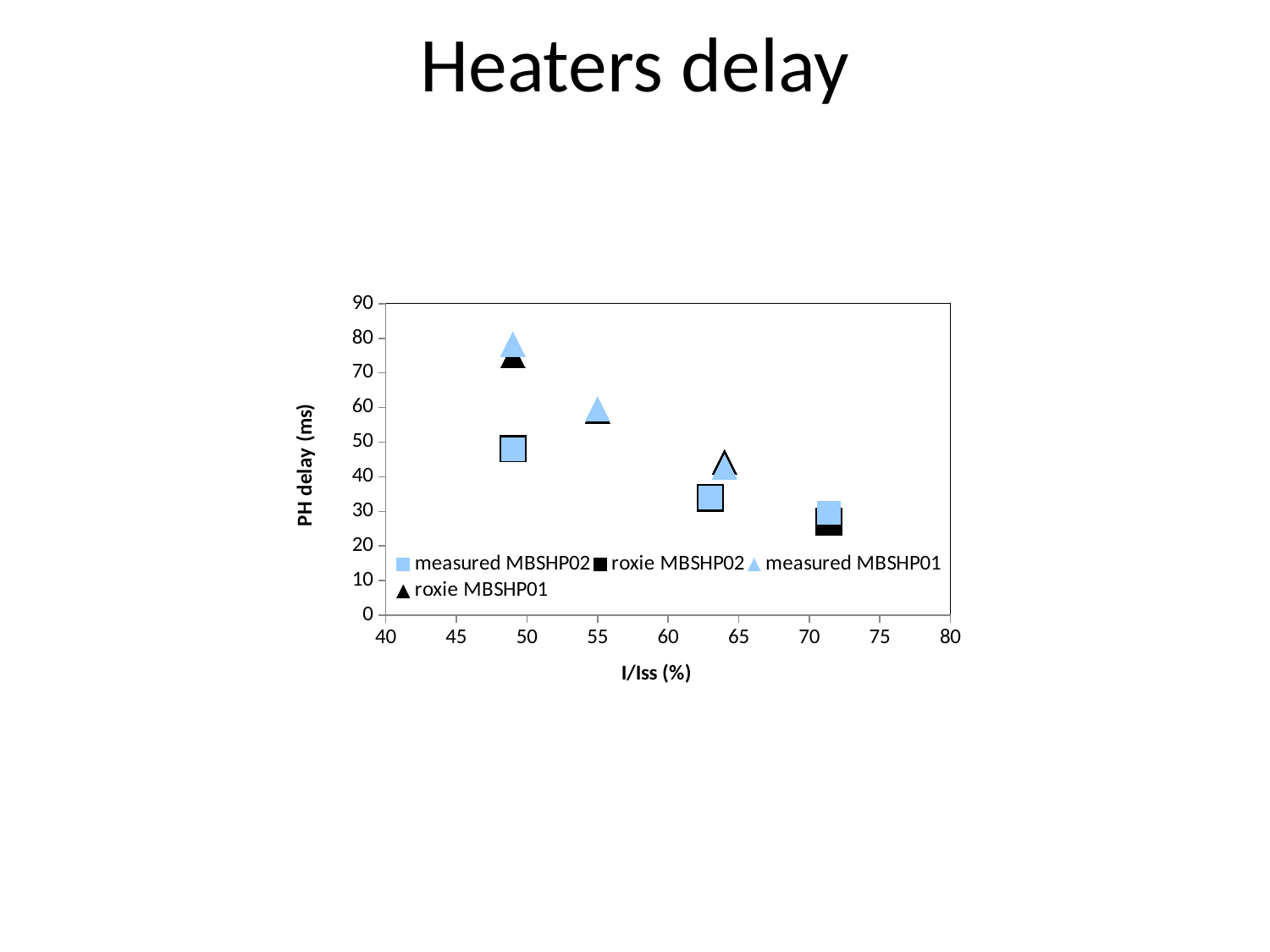
Is the PH delay for the measured MBSHP01 point near I/Iss 49% greater or less than 70? greater How many points are plotted for the measured MBSHP01 series? 3 Do the PH delay values rise or fall as I/Iss increases? fall What is the title of the chart? Heaters delay What is the label of the y axis? PH delay (ms) What kind of chart is shown on the slide? scatter chart Which series contains the point with the highest PH delay on the chart? measured MBSHP01 Is the PH delay for the measured MBSHP02 point near I/Iss 71% greater or less than 40? less How many points are plotted for the measured MBSHP02 series? 3 Is the PH delay for the measured MBSHP01 point near I/Iss 55% greater or less than 50? greater Near I/Iss 49%, which series has the larger PH delay: measured MBSHP01 or measured MBSHP02? measured MBSHP01 How many series does the legend list? 4